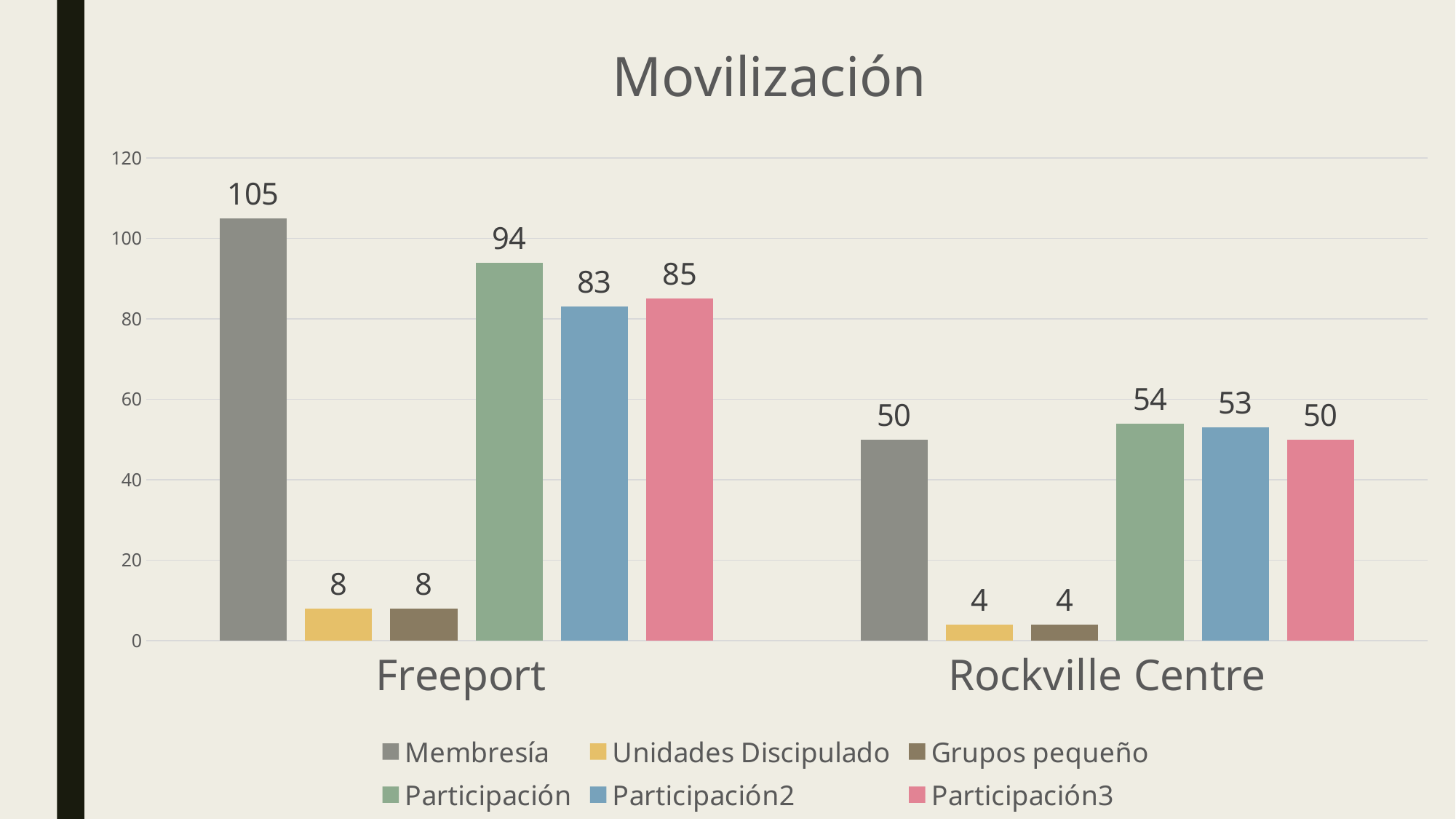
What is the Participación2 value for Rockville Centre? 53 What is the difference between the Membresía values for Freeport and Rockville Centre? 55 What is the Membresía value for Freeport? 105 What is the title of the chart? Movilización Which category has the highest Membresía value? Freeport What is the Participación3 value for Freeport? 85 How many series does the legend list? 6 Which is larger for Freeport: Participación or Participación2? Participación How many categories are shown on the x axis? 2 Which series has the lowest value for Freeport? Unidades Discipulado and Grupos pequeño (both 8) What kind of chart is shown? Bar chart What is the Unidades Discipulado value for Rockville Centre? 4